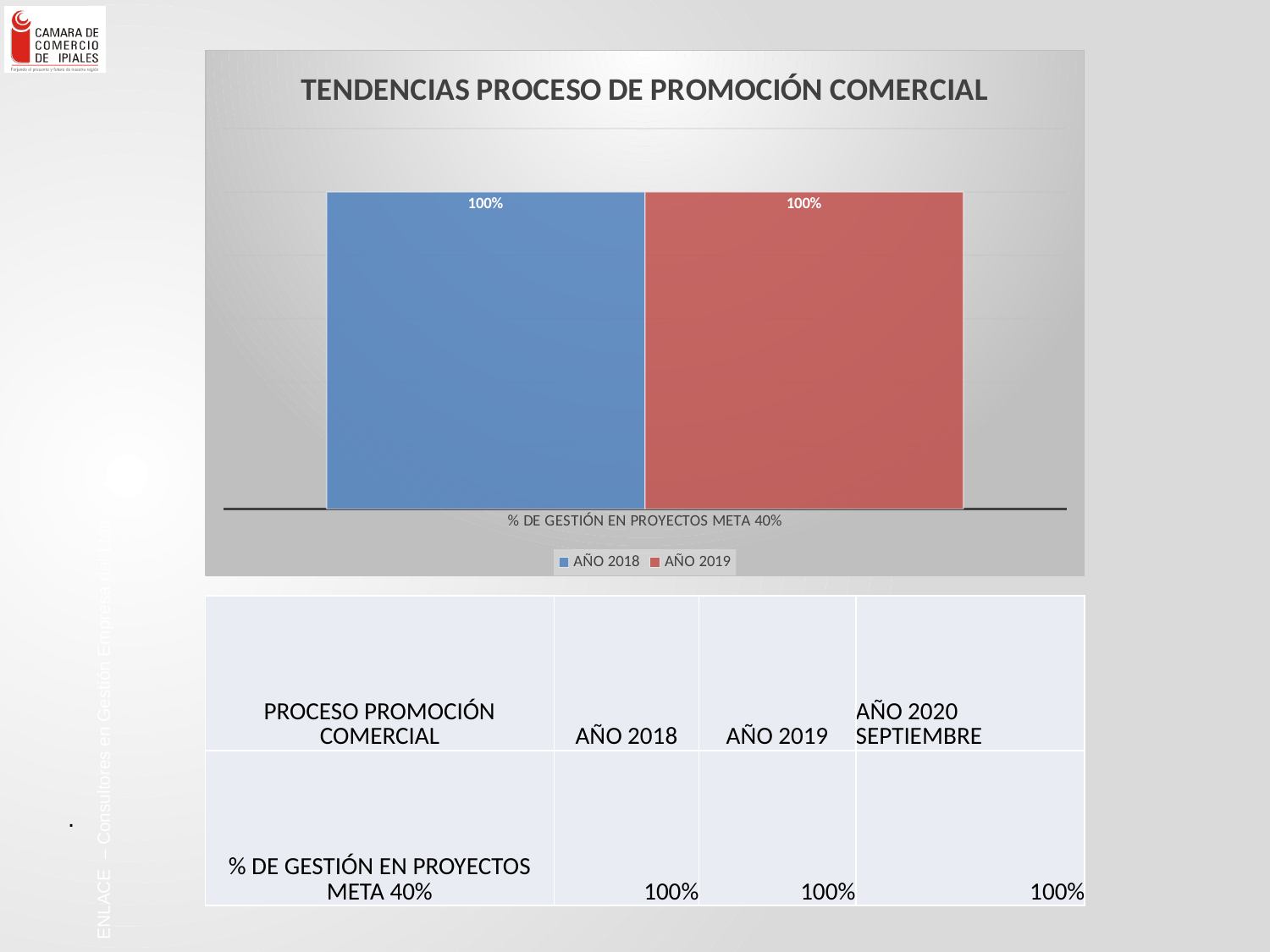
What is the value for AÑO 2019 in the chart? 100% What kind of chart is shown on the slide? Bar chart How many categories are shown on the x axis of the chart? 1 What is the value for AÑO 2018 in the chart? 100% What is the category label on the x axis of the chart? % DE GESTIÓN EN PROYECTOS META 40% Which series is shown in red in the chart? AÑO 2019 What is the title of the chart? TENDENCIAS PROCESO DE PROMOCIÓN COMERCIAL How many series does the chart legend list? 2 What is the difference between the AÑO 2018 and AÑO 2019 values in the chart? 0%